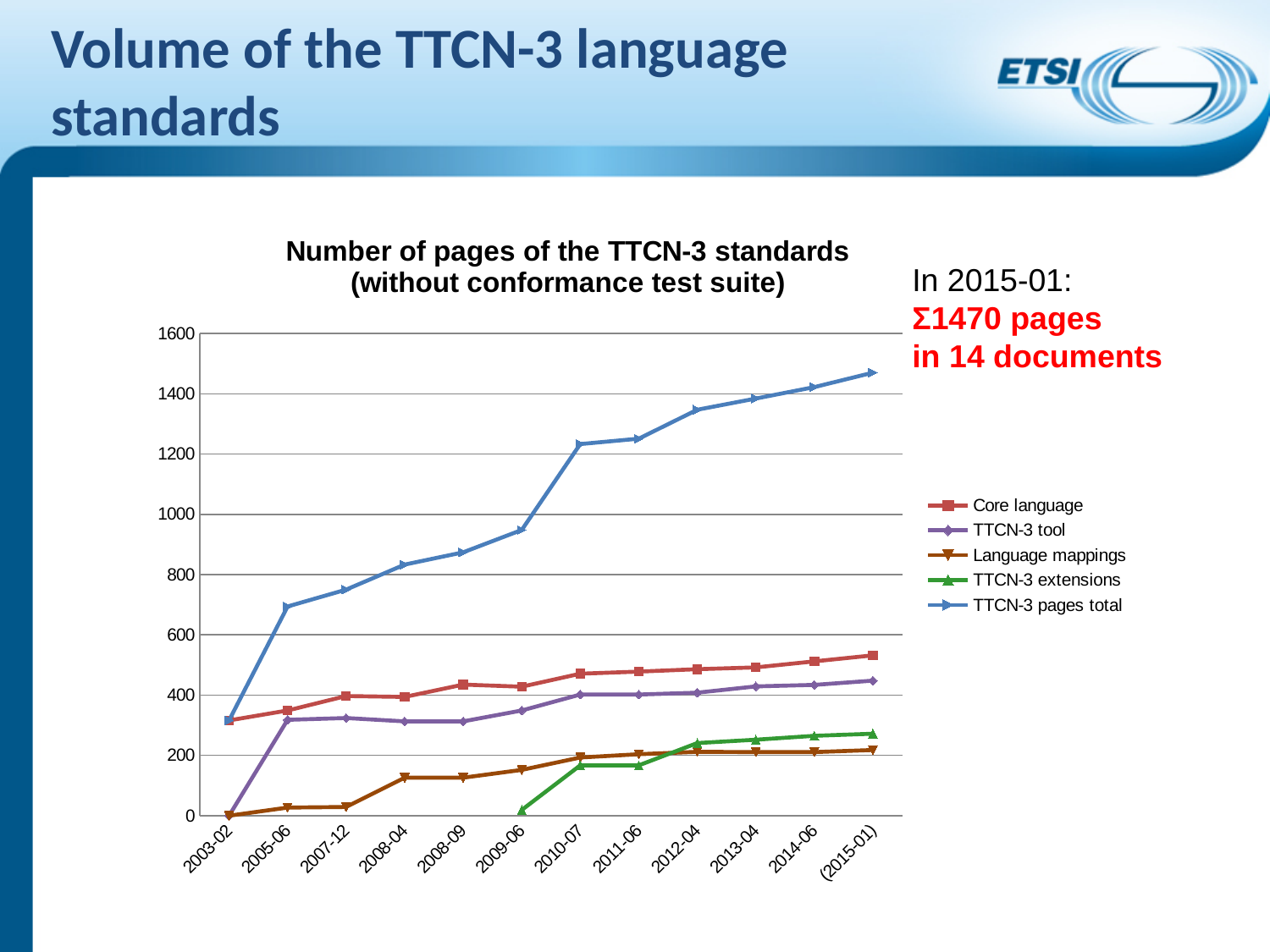
How many time points are shown along the x axis? 12 What kind of chart is shown on the slide? line chart Is the value for Core language at (2015-01) greater or less than 600? less What is the title of the chart? Number of pages of the TTCN-3 standards (without conformance test suite) Does the TTCN-3 pages total series rise or fall from 2003-02 to (2015-01)? rise At 2012-04, which is larger: Core language or TTCN-3 tool? Core language Is the value for TTCN-3 pages total at (2015-01) greater or less than 1400? greater Which series has the highest value at (2015-01)? TTCN-3 pages total Is the value for Language mappings at 2008-04 greater or less than 200? less Which series has the lowest value at (2015-01)? Language mappings According to the slide, how many pages in total do the TTCN-3 standards have in 2015-01? 1470 How many series does the legend list? 5